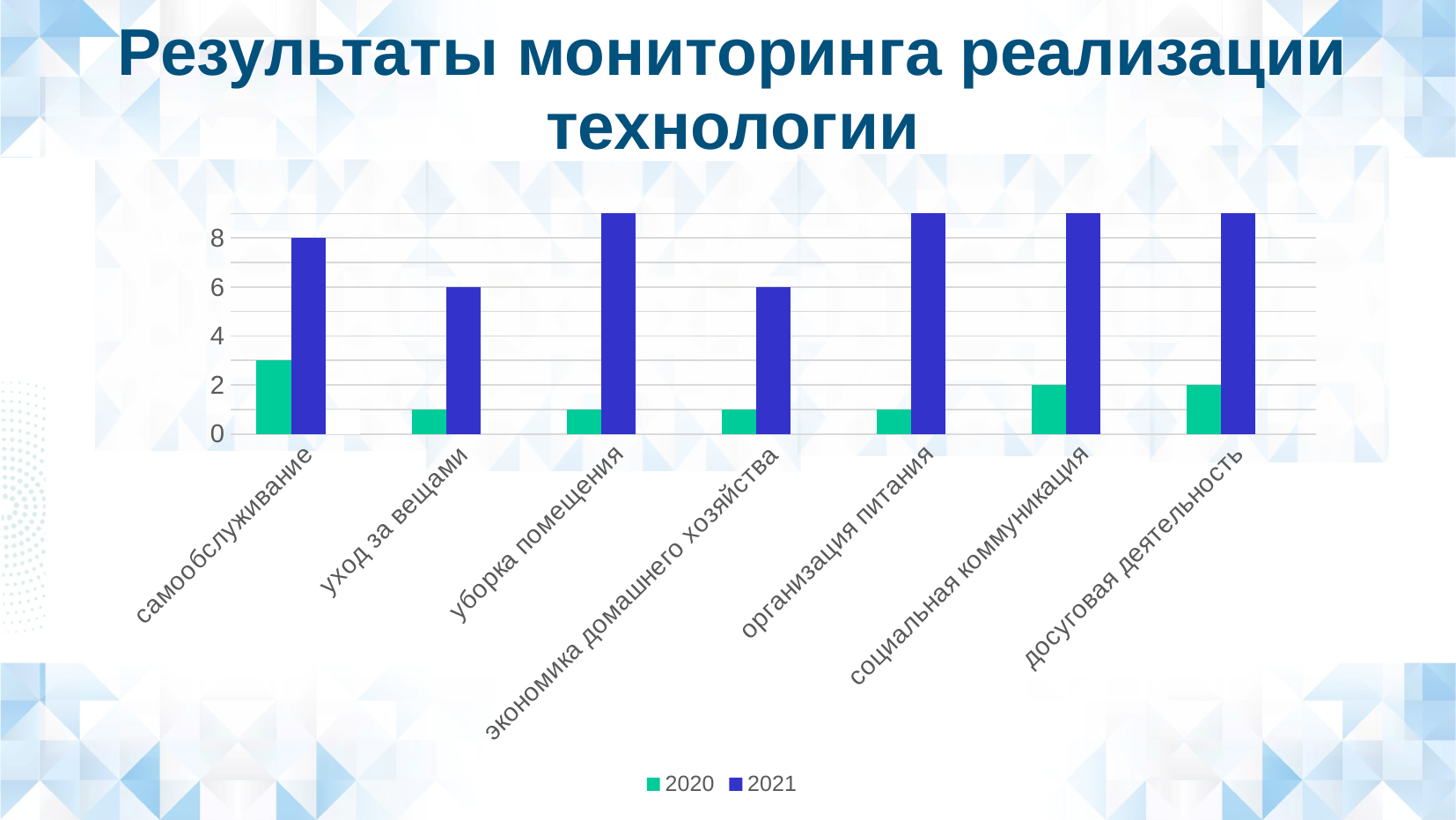
What is the value for уход за вещами in the 2021 series? 6 What is the difference between the 2021 values for самообслуживание and экономика домашнего хозяйства? 2 How many categories are shown on the x axis? 7 Which series is shown in green in the legend? 2020 What is the value for самообслуживание in the 2021 series? 8 Is the 2021 value for уборка помещения greater or less than 8? greater In the 2021 series, which is larger: самообслуживание or уход за вещами? самообслуживание What kind of chart is shown on the slide? bar chart Which category has the highest value in the 2020 series? самообслуживание Is the 2020 value for организация питания greater or less than 2? less What is the value for социальная коммуникация in the 2020 series? 2 How many series does the legend list? 2